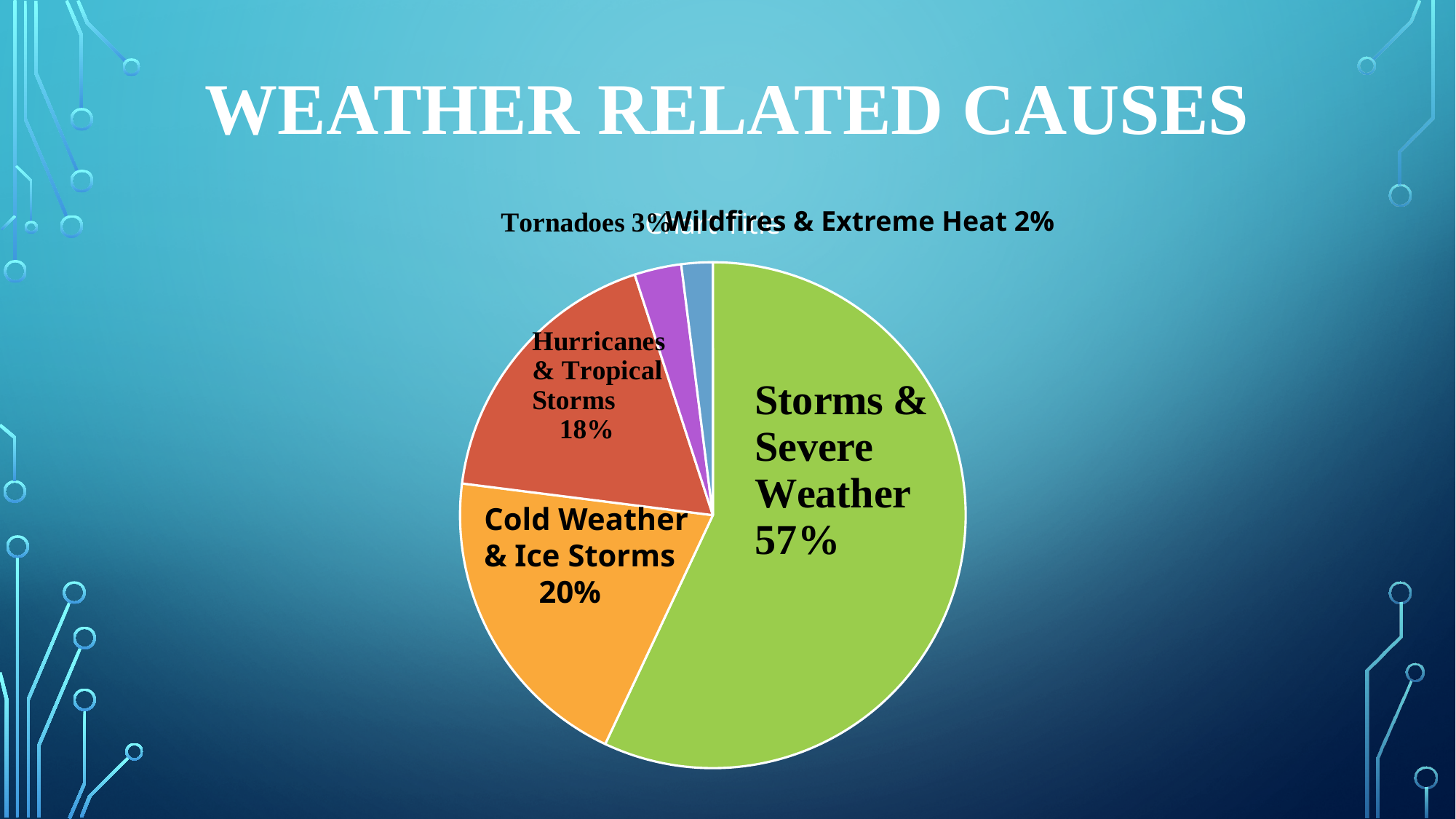
Which category has the largest slice of the pie? Storms & Severe Weather What colour is the Storms & Severe Weather slice? green What share of the pie is Tornadoes? 3% What share of the pie is Wildfires & Extreme Heat? 2% Which is larger, Cold Weather & Ice Storms or Hurricanes & Tropical Storms? Cold Weather & Ice Storms What share of the pie is Storms & Severe Weather? 57% How many slices does the pie chart have? 5 What kind of chart is shown on the slide? pie chart What is the difference in percentage points between Storms & Severe Weather and Cold Weather & Ice Storms? 37 Which category has the smallest slice of the pie? Wildfires & Extreme Heat